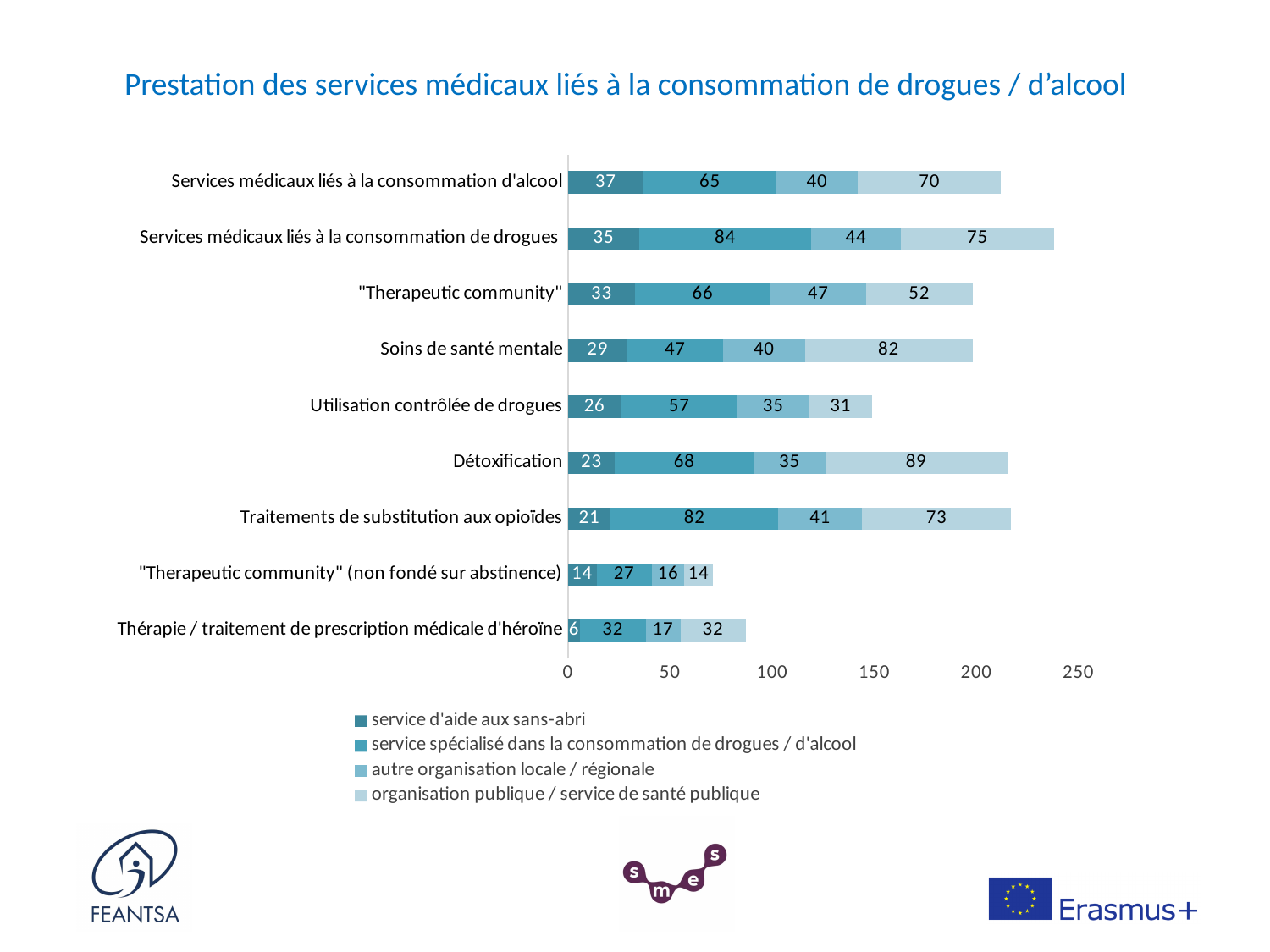
What is the value of 'service d'aide aux sans-abri' for 'Thérapie / traitement de prescription médicale d'héroïne'? 6 What is the title of the chart? Prestation des services médicaux liés à la consommation de drogues / d'alcool How many series does the legend list? 4 How many categories are plotted on the chart? 9 What is the total of the stacked bar for 'Services médicaux liés à la consommation de drogues'? 238 What type of chart is shown on the slide? Stacked bar chart Which category has the highest value for 'service d'aide aux sans-abri'? Services médicaux liés à la consommation d'alcool What is the difference between the 'organisation publique / service de santé publique' values for 'Soins de santé mentale' and 'Utilisation contrôlée de drogues'? 51 Which category has the lowest value for 'organisation publique / service de santé publique'? "Therapeutic community" (non fondé sur abstinence) What is the value of 'service spécialisé dans la consommation de drogues / d'alcool' for 'Services médicaux liés à la consommation de drogues'? 84 Which is larger: the 'autre organisation locale / régionale' value for '"Therapeutic community"' or for 'Traitements de substitution aux opioïdes'? "Therapeutic community" What is the value of 'organisation publique / service de santé publique' for 'Détoxification'? 89